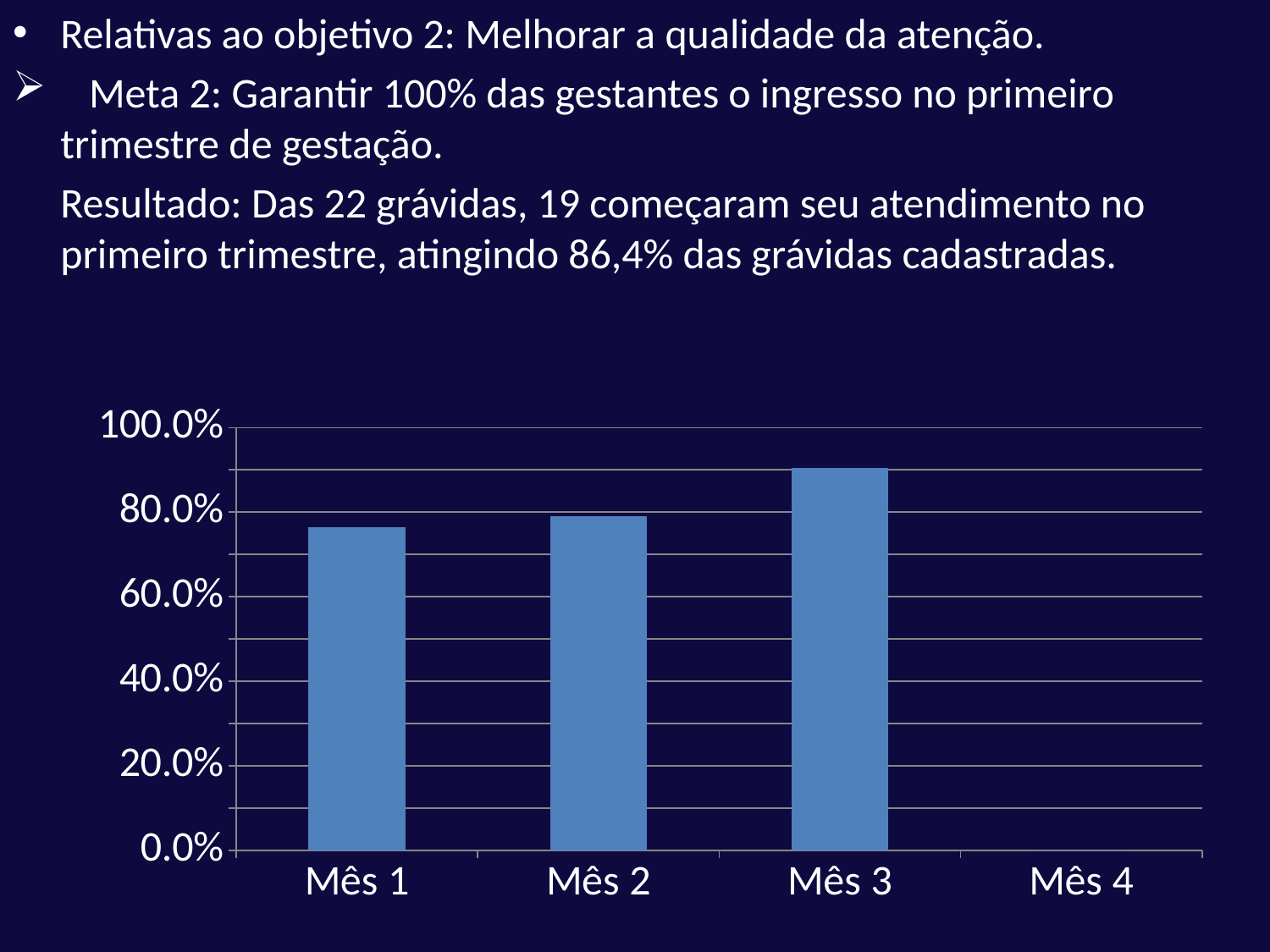
Which of the months with a bar has the lowest value? Mês 1 Which month has the highest bar in the chart? Mês 3 Is the value for Mês 1 greater or less than 60.0%? greater Is the value for Mês 3 greater or less than 100.0%? less What kind of chart is shown on the slide? bar chart Is the value for Mês 3 greater or less than 80.0%? greater Do the bar values rise or fall from Mês 1 to Mês 3? rise How many categories are shown on the x axis of the chart? 4 Which is larger, the value for Mês 1 or the value for Mês 3? Mês 3 Which month on the x axis has no bar plotted? Mês 4